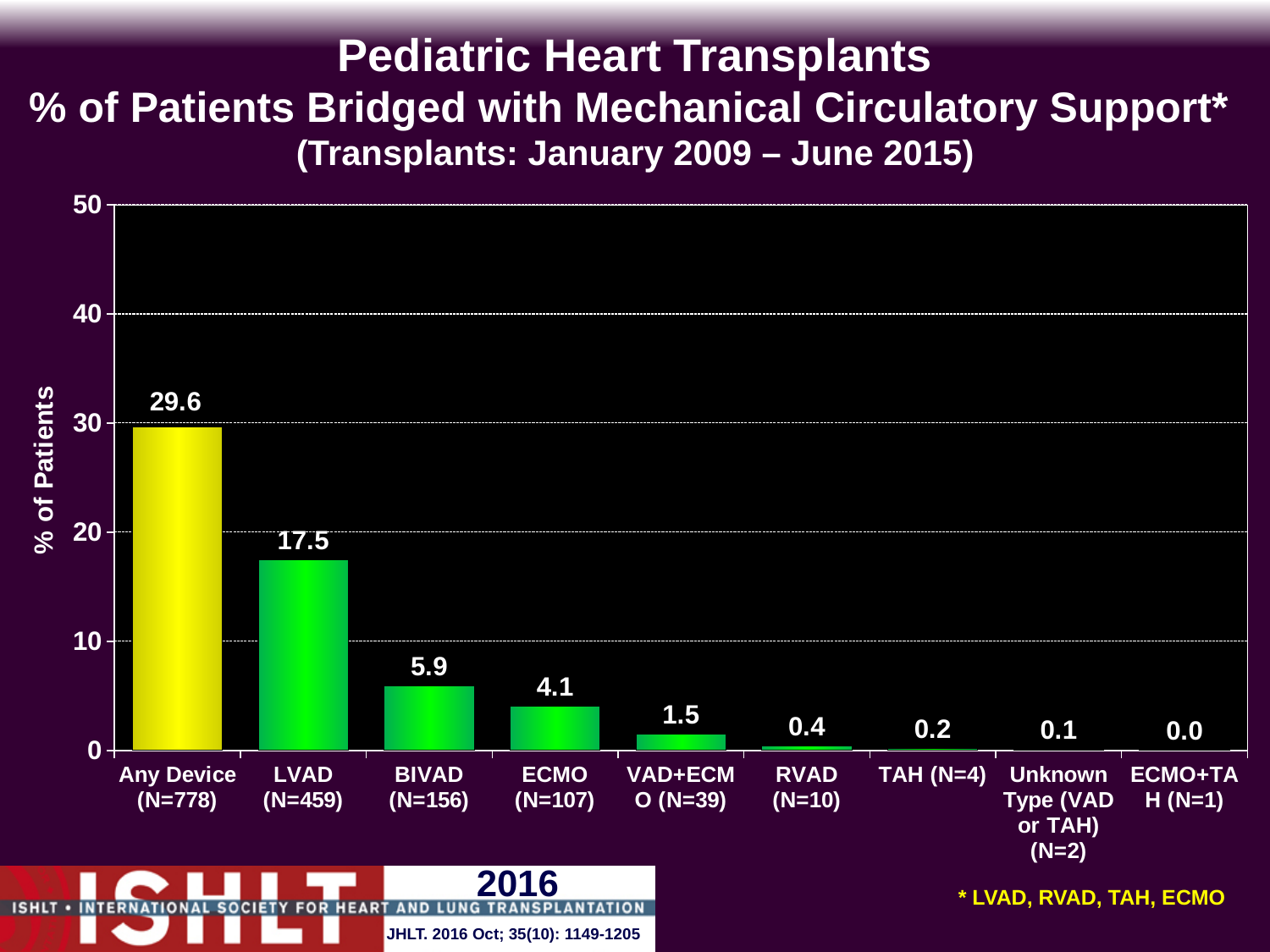
What is the label of the y axis? % of Patients What is the difference between the values for BIVAD (N=156) and ECMO (N=107)? 1.8 Which is larger, the value for BIVAD (N=156) or the value for RVAD (N=10)? BIVAD (N=156) Is the value for Any Device (N=778) greater or less than 20? greater What kind of chart is shown on the slide? bar chart What is the difference between the values for Any Device (N=778) and LVAD (N=459)? 12.1 Which category has the highest value? Any Device (N=778) Which category has the lowest value? ECMO+TAH (N=1) What is the value for ECMO (N=107)? 4.1 What is the value for VAD+ECMO (N=39)? 1.5 What is the value for LVAD (N=459)? 17.5 How many categories are shown on the x axis? 9